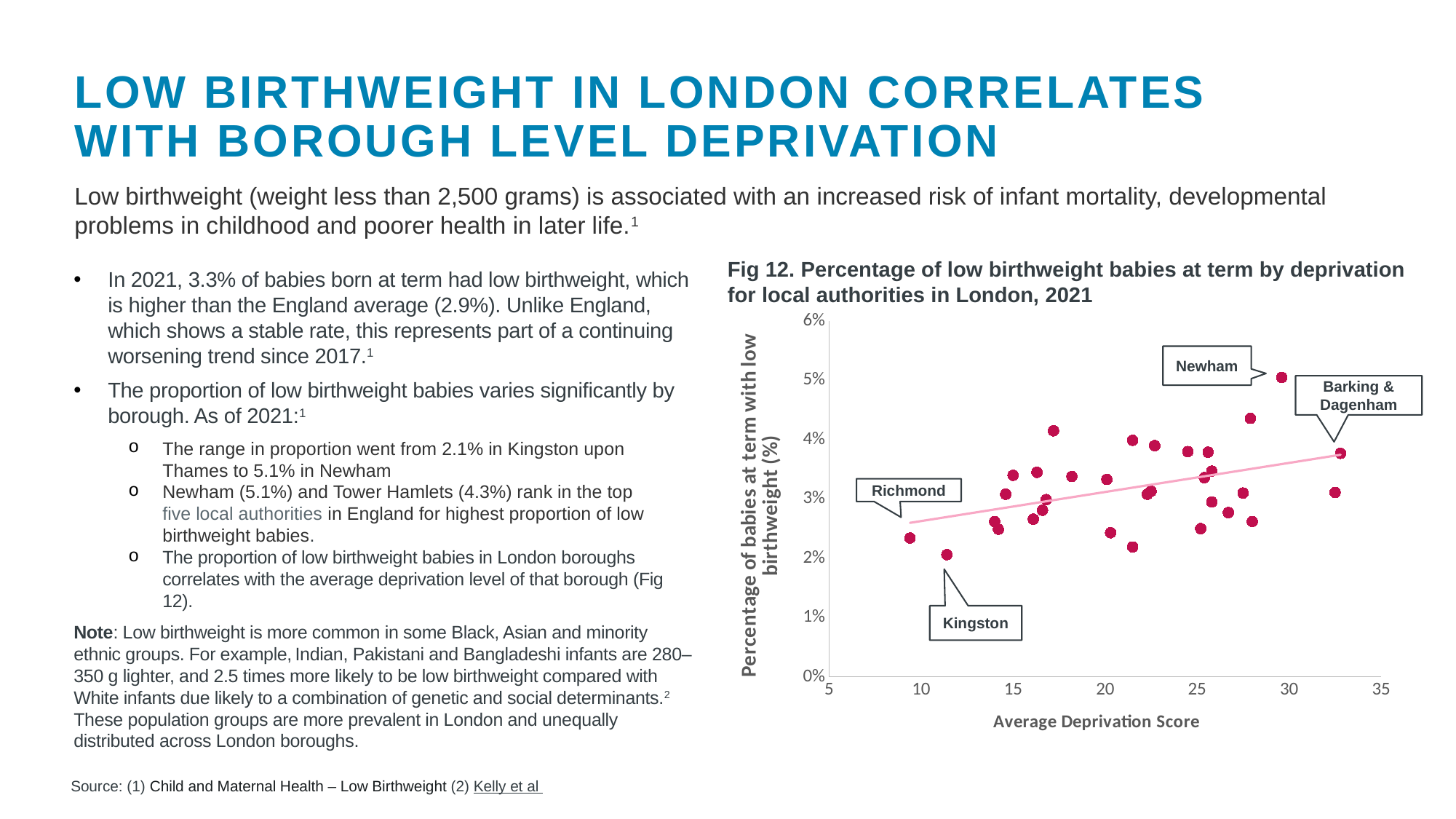
Is the percentage of low birthweight babies for Barking & Dagenham greater or less than 3%? greater Is the average deprivation score for Barking & Dagenham greater or less than 30? greater Is the percentage of low birthweight babies for Kingston greater or less than 3%? less What is the title of the chart? Fig 12. Percentage of low birthweight babies at term by deprivation for local authorities in London, 2021 What is the label of the x axis of the chart? Average Deprivation Score Which labelled borough has the lowest percentage of low birthweight babies at term? Kingston Which labelled borough has the highest percentage of low birthweight babies at term? Newham Which has a higher percentage of low birthweight babies, Richmond or Barking & Dagenham? Barking & Dagenham What kind of chart is Fig 12? scatter chart Does the trend line show the percentage of low birthweight babies rising or falling as the average deprivation score increases? rising